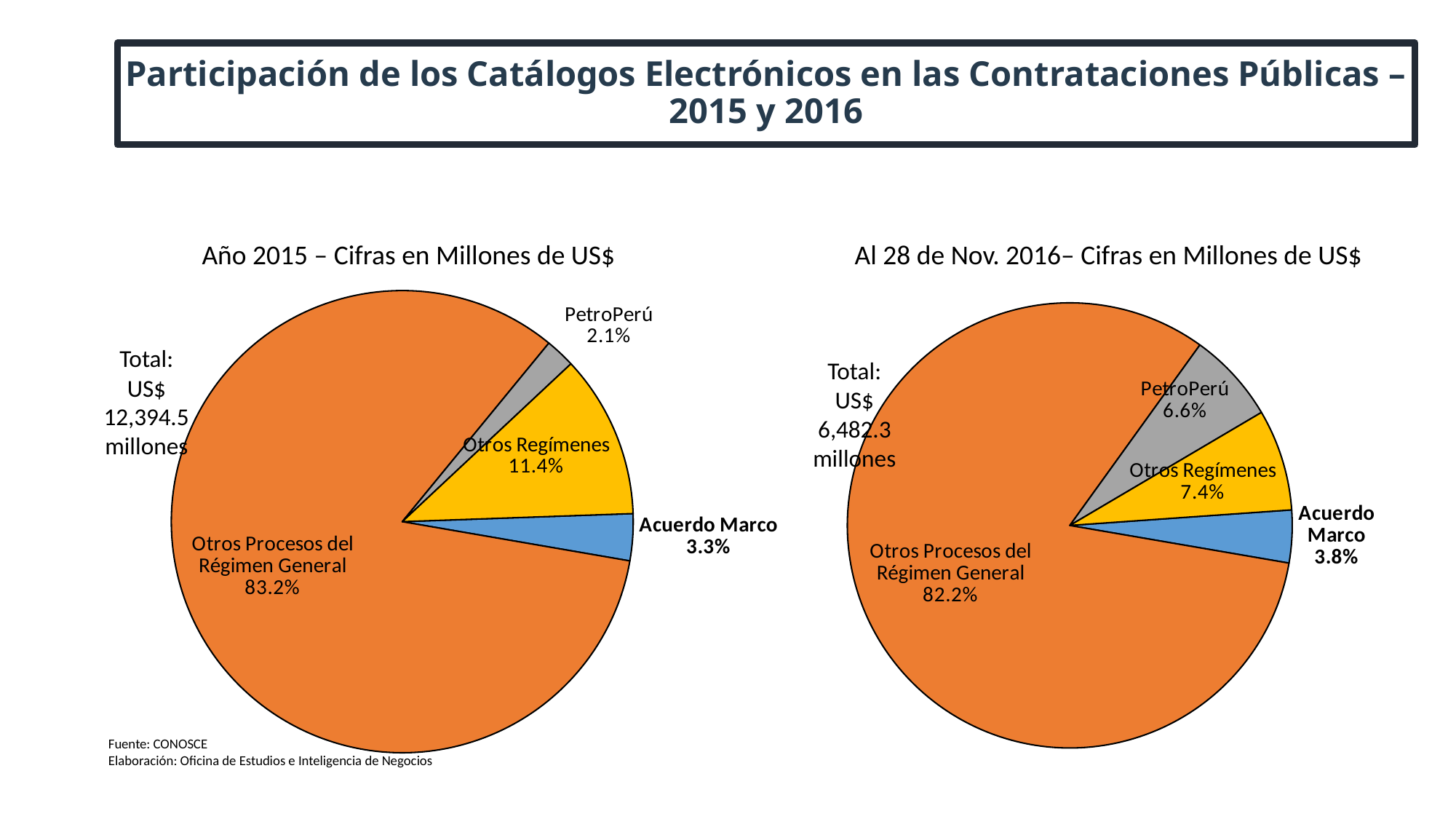
What type of chart is used on the left side of the slide? Pie chart In the 'Año 2015' pie chart, what colour is the Acuerdo Marco slice? Blue What is the difference between the Otros Regímenes share in the 'Año 2015' chart and in the 'Al 28 de Nov. 2016' chart? 4.0% In the 'Año 2015' pie chart, what share does Acuerdo Marco have? 3.3% In the 'Al 28 de Nov. 2016' pie chart, which category has the largest slice? Otros Procesos del Régimen General In the 'Año 2015' pie chart, what share does Otros Regímenes have? 11.4% In the 'Al 28 de Nov. 2016' pie chart, which is larger: PetroPerú or Acuerdo Marco? PetroPerú In the 'Al 28 de Nov. 2016' pie chart, what share does PetroPerú have? 6.6% How many slices does the 'Año 2015' pie chart have? 4 In the 'Al 28 de Nov. 2016' pie chart, which category has the smallest slice? Acuerdo Marco What total value is shown next to the 'Al 28 de Nov. 2016' pie chart? US$ 6,482.3 millones In the 'Año 2015' pie chart, which category has the smallest slice? PetroPerú